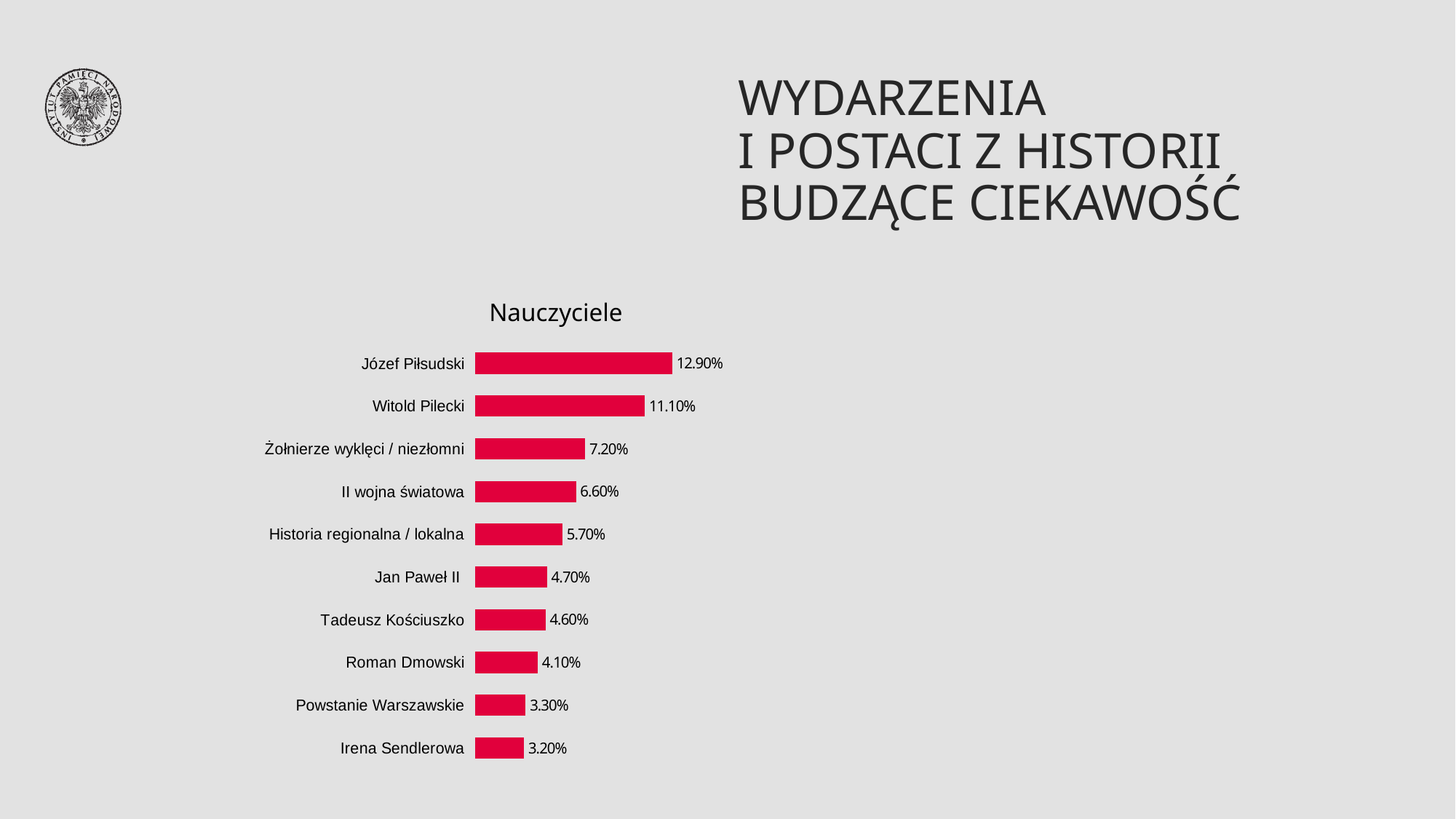
What colour are the bars in the chart? Red Which is larger, the value for Witold Pilecki or the value for Jan Paweł II? Witold Pilecki What is the value for Powstanie Warszawskie? 3.30% What is the value for Historia regionalna / lokalna? 5.70% What kind of chart is shown on the slide? Bar chart What is the title of the chart? Nauczyciele What is the value for Józef Piłsudski? 12.90% What is the difference between the values for Józef Piłsudski and Witold Pilecki? 1.80% Which category has the highest value? Józef Piłsudski What is the difference between the values for Żołnierze wyklęci / niezłomni and II wojna światowa? 0.60% How many categories are shown in the chart? 10 Which category has the lowest value? Irena Sendlerowa